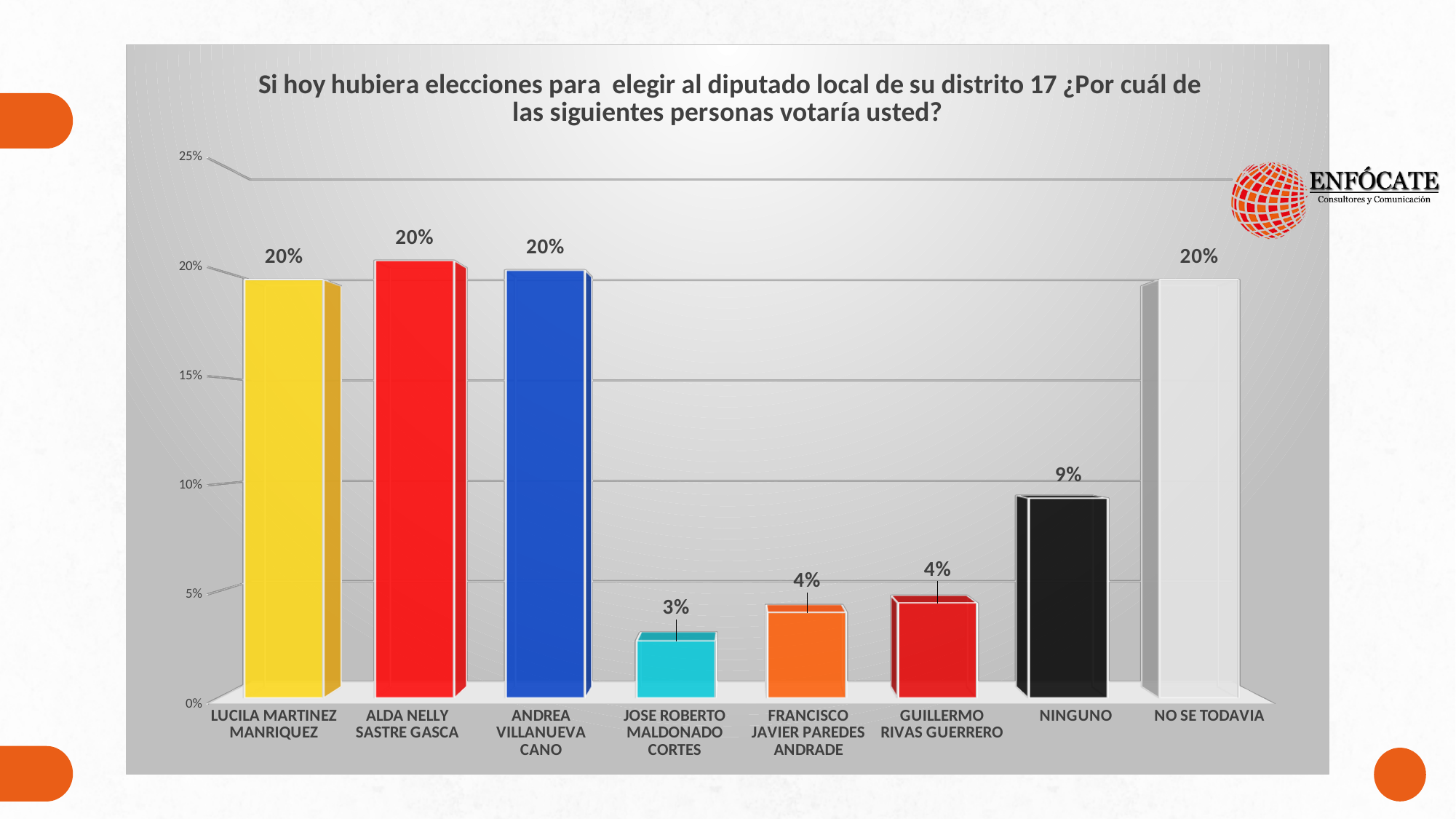
What kind of chart is shown on the slide? bar chart Is the value for Ninguno greater or less than 10%? less What percentage of respondents said they would vote for Lucila Martinez Manriquez? 20% What is the difference between the value for Ninguno and the value for Jose Roberto Maldonado Cortes? 6% What is the value shown for Jose Roberto Maldonado Cortes? 3% What is the value for Francisco Javier Paredes Andrade? 4% What colour is the bar for Andrea Villanueva Cano? blue What percentage is shown for Ninguno? 9% What is the difference between the value for Alda Nelly Sastre Gasca and the value for Guillermo Rivas Guerrero? 16% Which candidate or option has the lowest percentage? Jose Roberto Maldonado Cortes How many categories are shown on the x axis of the chart? 8 Which is larger, the value for Ninguno or the value for Guillermo Rivas Guerrero? Ninguno